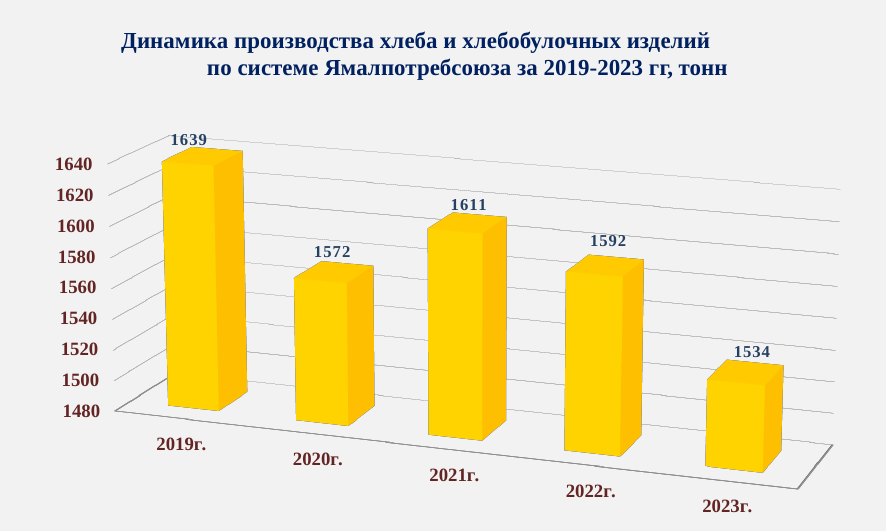
What was the bread production in 2019г.? 1639 What is the title of the chart? Динамика производства хлеба и хлебобулочных изделий по системе Ямалпотребсоюза за 2019-2023 гг, тонн What value is shown for 2023г.? 1534 How many years are shown on the chart? 5 What is the difference between the values for 2019г. and 2023г.? 105 What kind of chart is this? bar chart Is the value for 2022г. greater or less than 1600? less What is the difference between the values for 2021г. and 2020г.? 39 Which is larger, the value for 2020г. or the value for 2022г.? 2022г. What value is shown for 2021г.? 1611 Which year has the lowest production? 2023г. Which year has the highest production? 2019г.